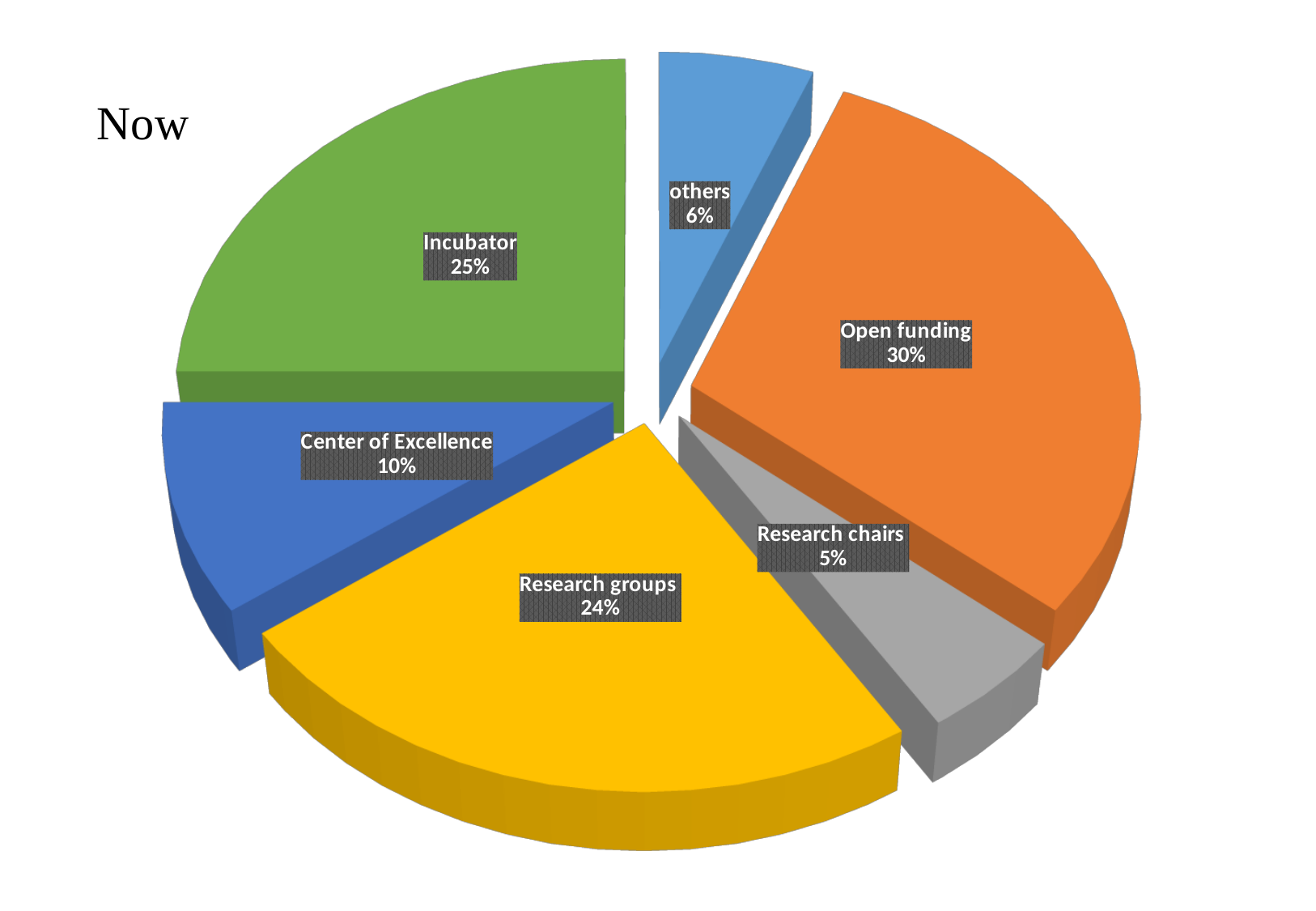
What percentage is shown for Research groups? 24% Which is larger, the others slice or the Research chairs slice? others Which category has the largest slice of the pie? Open funding What is the text label shown at the top left of the slide? Now Which is larger, Incubator or Center of Excellence? Incubator What share of the pie does Open funding have? 30% What is the difference between Open funding and Center of Excellence? 20% What is the value for Center of Excellence? 10% What is the difference between the Incubator share and the Research groups share? 1% How many categories are shown in the pie chart? 6 Which category has the smallest slice of the pie? Research chairs What kind of chart is shown on the slide? Pie chart